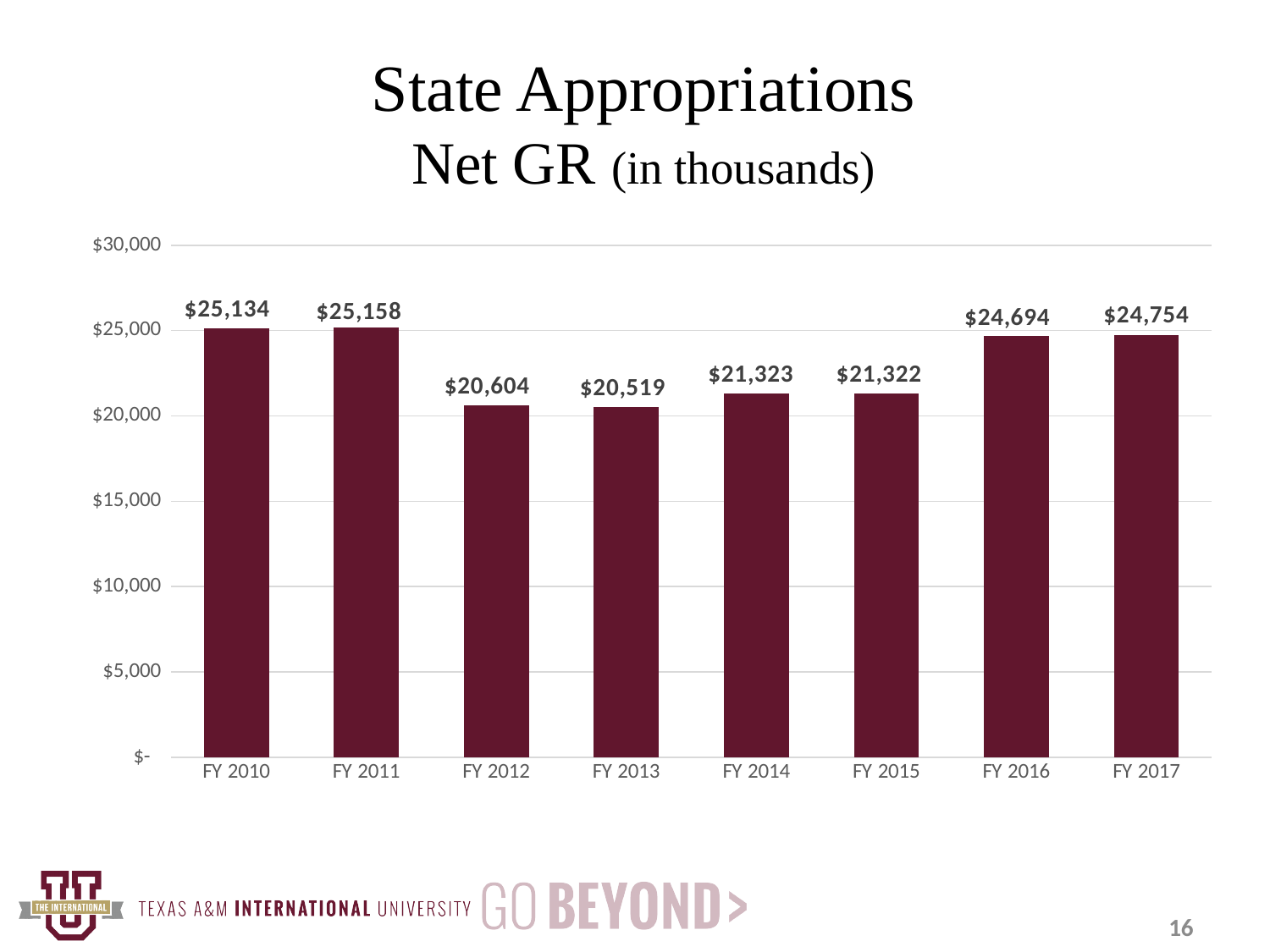
Which is larger, the value for FY 2014 or the value for FY 2015? FY 2014 Is the value for FY 2012 greater or less than $25,000? less How many fiscal years are shown on the chart? 8 What is the value for FY 2010? $25,134 What is the value for FY 2016? $24,694 Do the values rise or fall from FY 2013 to FY 2017? rise overall, though FY 2015 dips slightly below FY 2014 What is the difference between the values for FY 2017 and FY 2016? $60 What is the difference between the values for FY 2010 and FY 2012? $4,530 What kind of chart is shown on the slide? bar chart Which fiscal year has the lowest value? FY 2013 What is the value for FY 2013? $20,519 Which fiscal year has the highest value? FY 2011